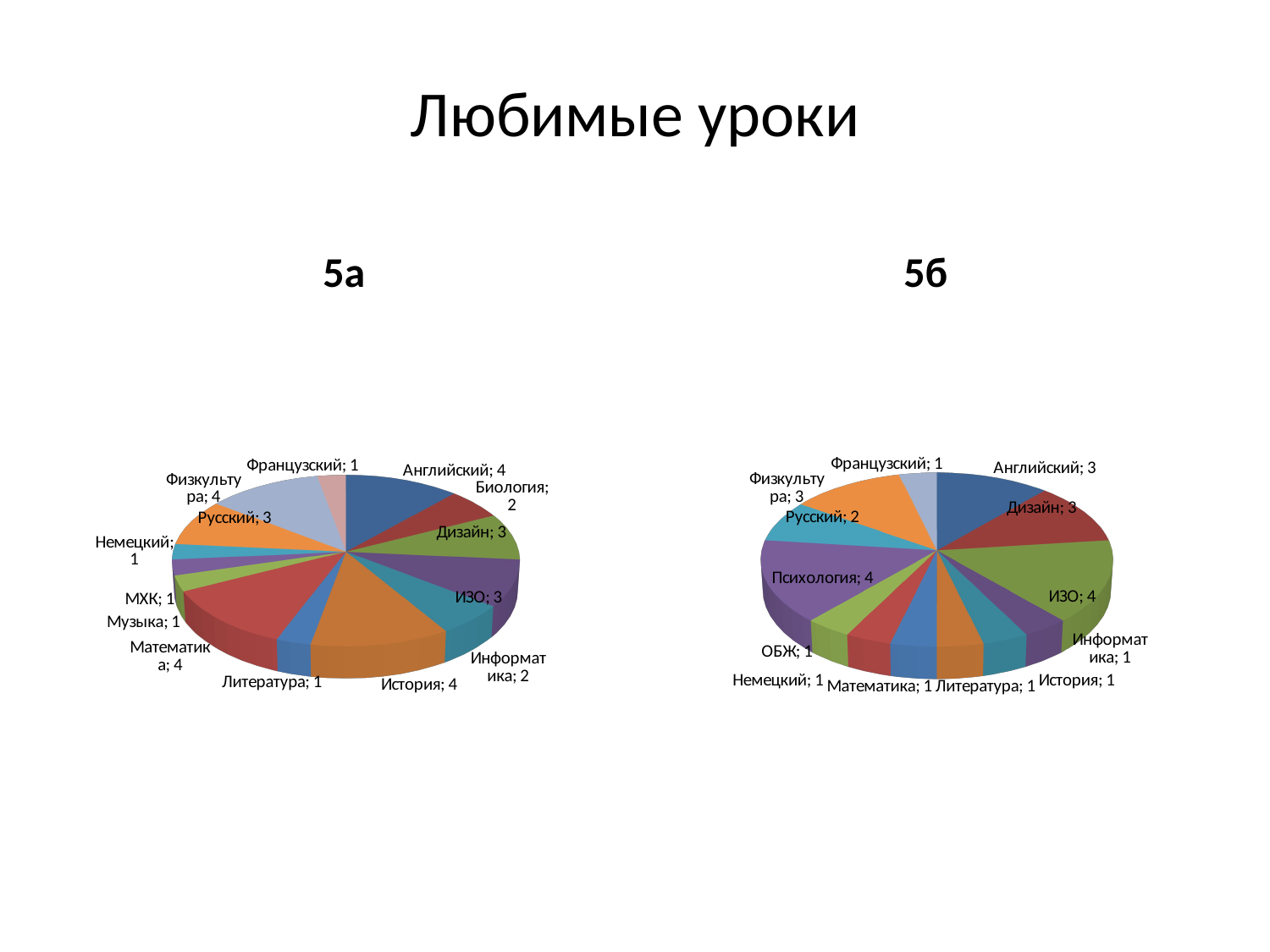
In the 5б chart, what is the value for Психология? 4 What kind of chart is the 5б chart? Pie chart In the 5а chart, what is the value for История? 4 In the 5а chart, what is the value for Биология? 2 In the 5а chart, which is larger, Физкультура or Русский? Физкультура How many categories does the 5б chart show? 13 In the 5б chart, what is the difference between the values for ИЗО and Информатика? 3 In the 5а chart, what is the difference between the values for Математика and Литература? 3 In the 5б chart, which is larger, Английский or История? Английский In the 5б chart, what is the value for Русский? 2 What is the title of the slide? Любимые уроки How many categories does the 5а chart show? 14